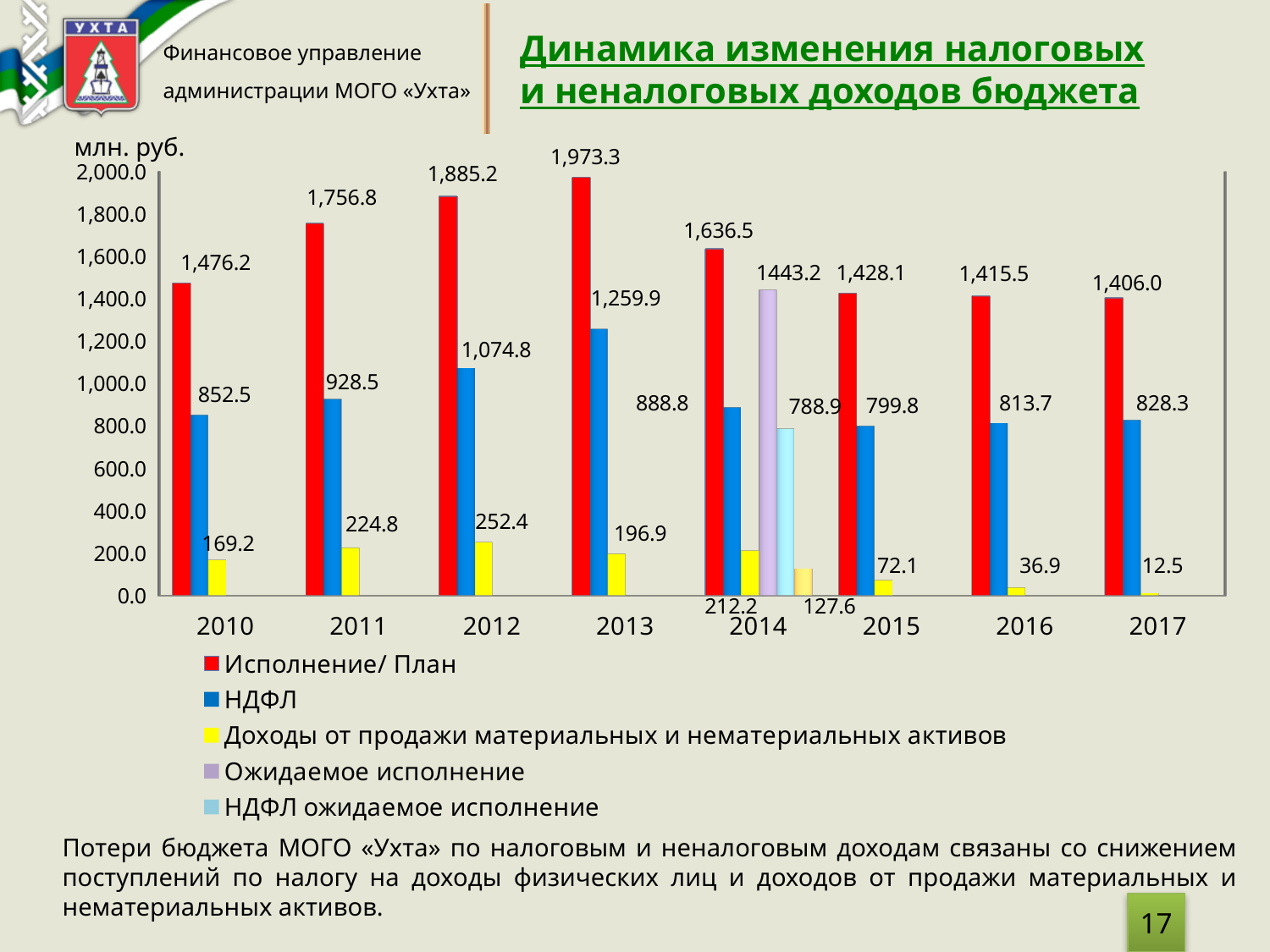
What is the value of Исполнение/ План for 2013? 1,973.3 How many series does the legend list? 5 What is the value of НДФЛ for 2012? 1,074.8 Which year has the larger НДФЛ value, 2016 or 2017? 2017 What is the difference between Исполнение/ План in 2013 and in 2010? 497.1 What is the value of Доходы от продажи материальных и нематериальных активов for 2017? 12.5 How many years are shown on the x axis? 8 What is the value of Ожидаемое исполнение for 2014? 1443.2 Does Исполнение/ План rise or fall from 2013 to 2017? fall In which year is Исполнение/ План the highest? 2013 In which year is Доходы от продажи материальных и нематериальных активов the lowest? 2017 What kind of chart is shown on the slide? bar chart